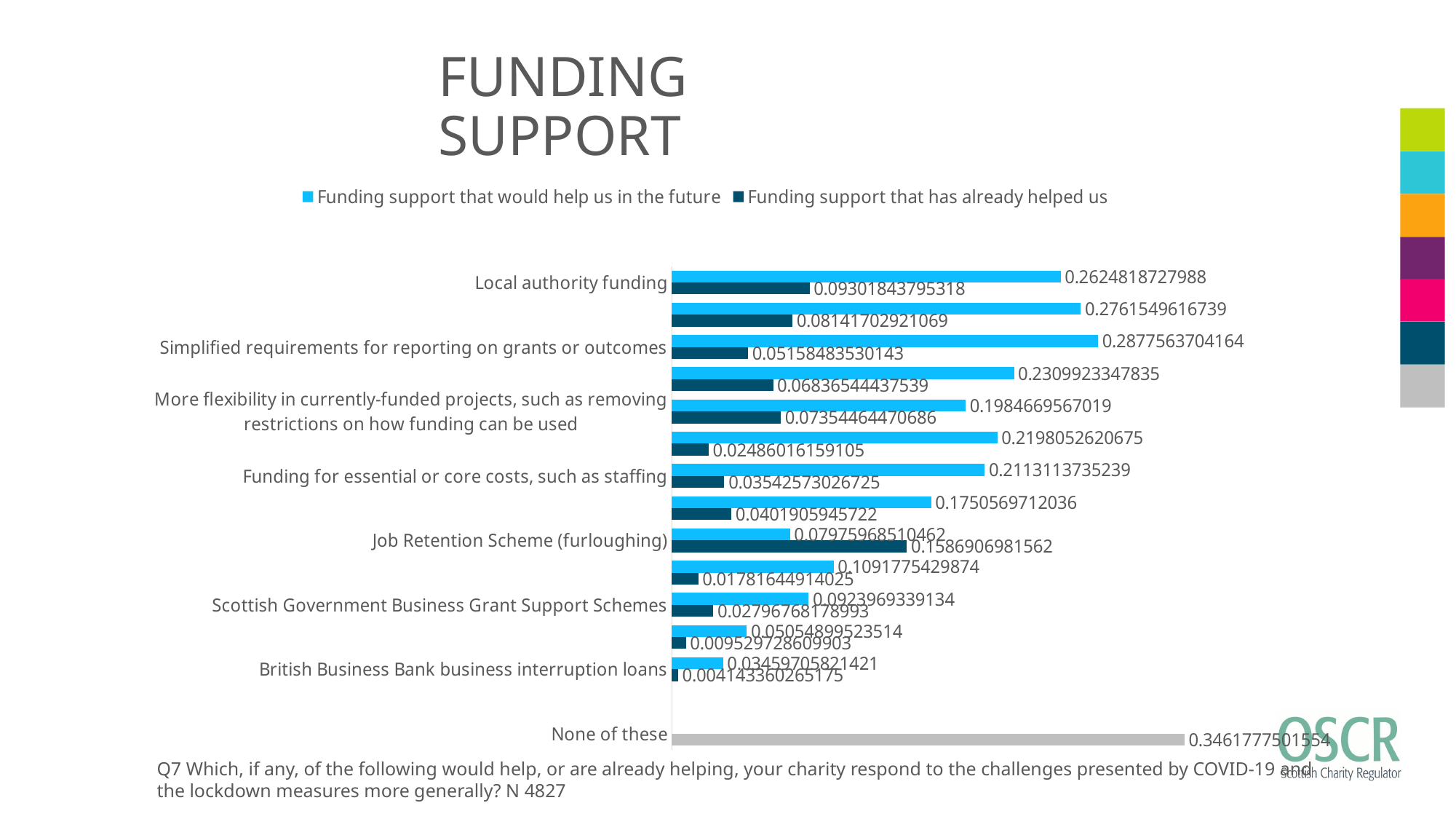
What is the value of 'Funding support that has already helped us' for Job Retention Scheme (furloughing)? 0.1586906981562 How many series does the legend list? 2 What kind of chart is shown on the slide? Bar chart What is the difference between the two series' values for Local authority funding? 0.16946343484562 Which category has the highest value for 'Funding support that has already helped us'? Job Retention Scheme (furloughing) What is the value of 'Funding support that has already helped us' for Local authority funding? 0.09301843795318 For Job Retention Scheme (furloughing), which series has the larger value? Funding support that has already helped us What is the value of 'Funding support that would help us in the future' for Local authority funding? 0.2624818727988 Which category has the lowest value for 'Funding support that has already helped us'? British Business Bank business interruption loans Which category has the highest value for 'Funding support that would help us in the future'? Simplified requirements for reporting on grants or outcomes What is the value of 'Funding support that would help us in the future' for Simplified requirements for reporting on grants or outcomes? 0.2877563704164 What is the value of 'Funding support that has already helped us' for British Business Bank business interruption loans? 0.004143360265175